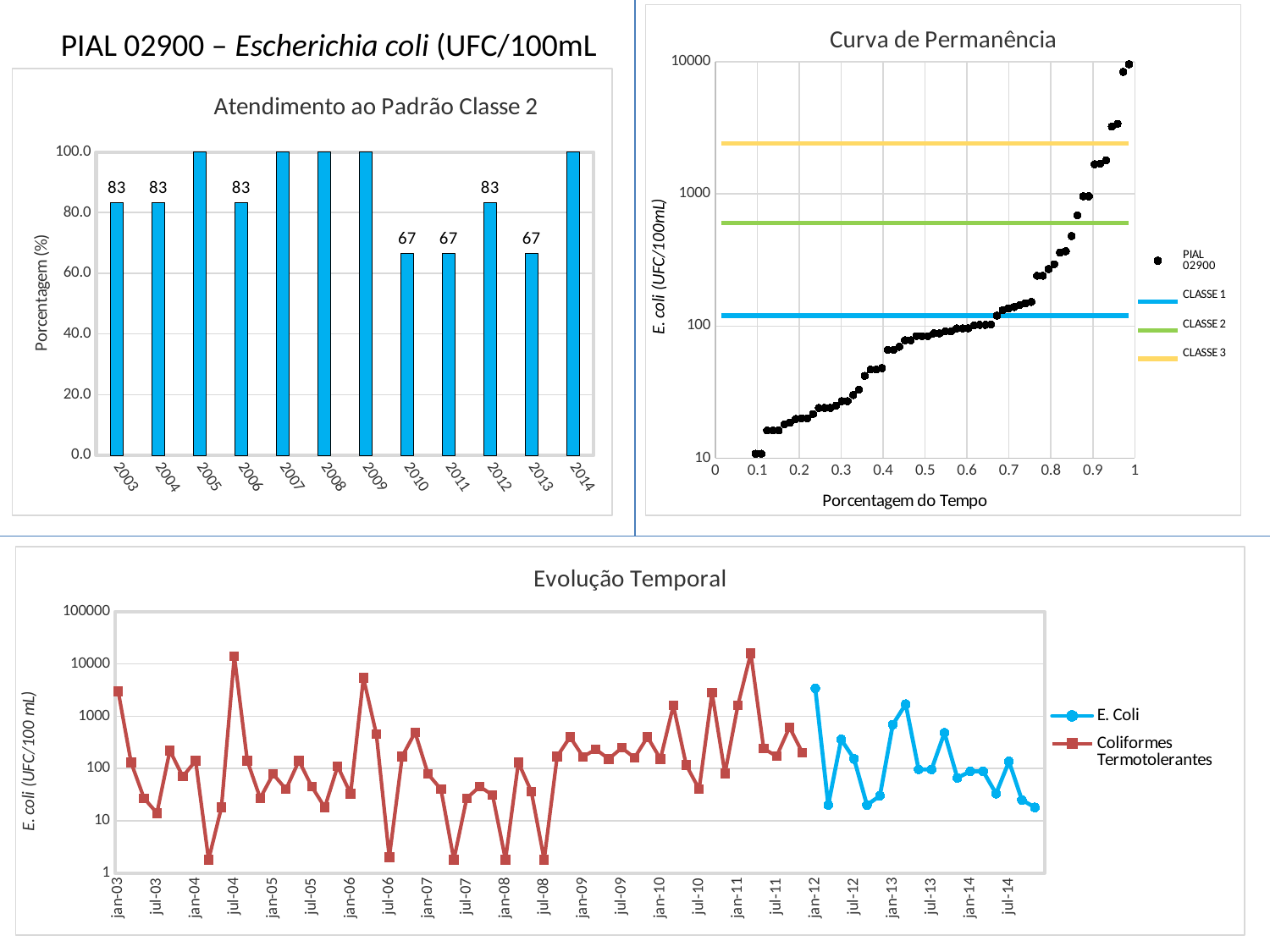
In the 'Atendimento ao Padrão Classe 2' chart, what is the difference between the values for 2004 and 2010? 16 How many series does the legend of the 'Evolução Temporal' chart list? 2 In the 'Evolução Temporal' chart, which series is drawn in blue? E. Coli In the 'Curva de Permanência' chart, is the CLASSE 2 line greater or less than 1000? less What kind of chart is 'Atendimento ao Padrão Classe 2'? bar chart In the 'Atendimento ao Padrão Classe 2' chart, what is the value for 2012? 83 In the 'Atendimento ao Padrão Classe 2' chart, is the value for 2005 greater or less than 80? greater In the 'Atendimento ao Padrão Classe 2' chart, which year has the larger value, 2006 or 2013? 2006 In the 'Atendimento ao Padrão Classe 2' chart, how many years are shown on the x axis? 12 In the 'Atendimento ao Padrão Classe 2' chart, what is the value for 2010? 67 How many entries does the legend of the 'Curva de Permanência' chart list? 4 In the 'Atendimento ao Padrão Classe 2' chart, is the value for 2011 greater or less than 80? less